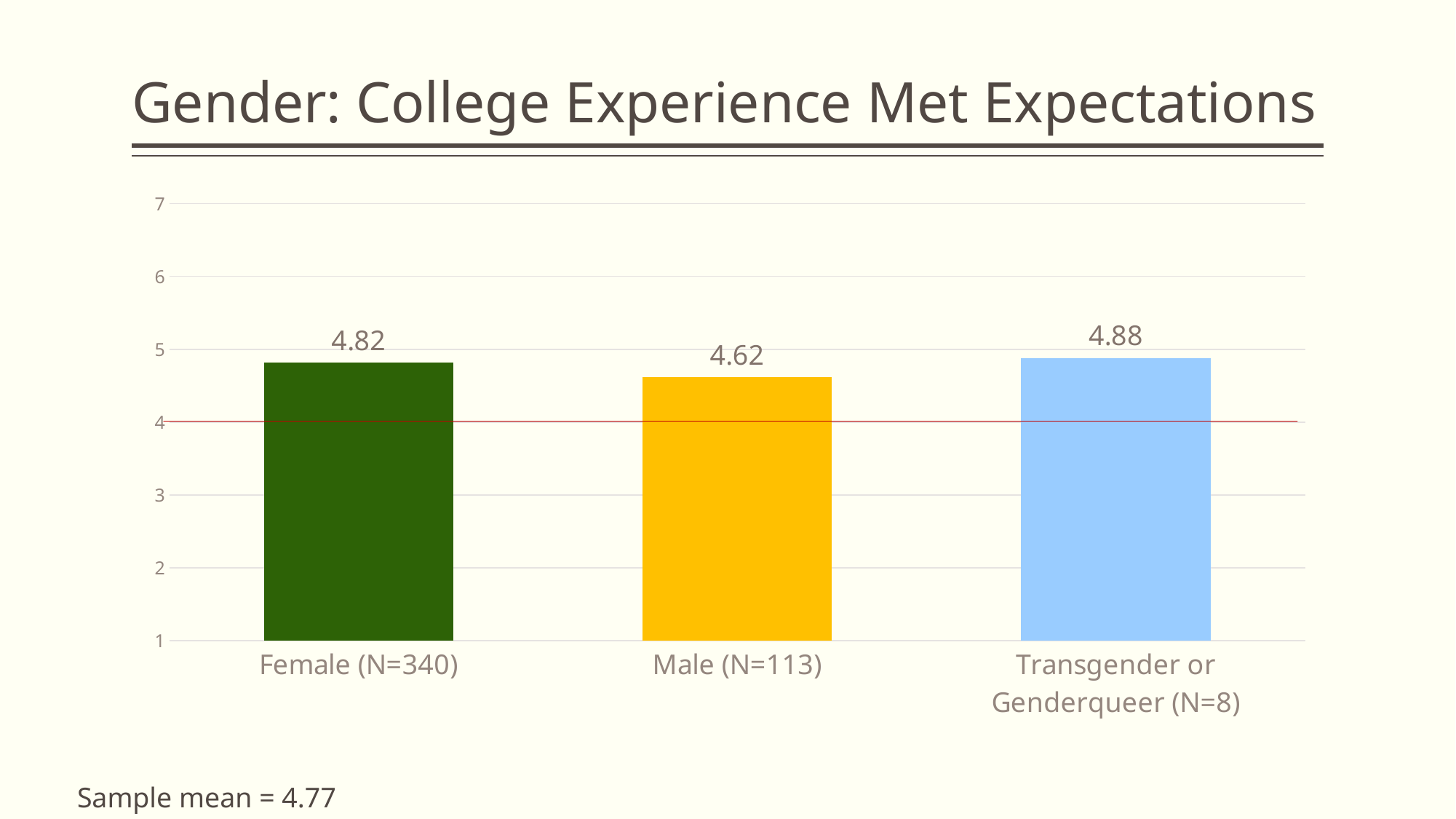
What is the difference between the values for Transgender or Genderqueer (N=8) and Male (N=113)? 0.26 Which category has the highest value? Transgender or Genderqueer (N=8) What is the value for Male (N=113)? 4.62 What kind of chart is shown on the slide? bar chart What is the title of the chart? Gender: College Experience Met Expectations How many categories are shown on the x axis? 3 Is the value for Male (N=113) greater or less than 4? greater What is the difference between the values for Female (N=340) and Male (N=113)? 0.20 What is the value for Female (N=340)? 4.82 What is the value for Transgender or Genderqueer (N=8)? 4.88 Which is larger, the value for Female (N=340) or the value for Male (N=113)? Female (N=340) Which category has the lowest value? Male (N=113)